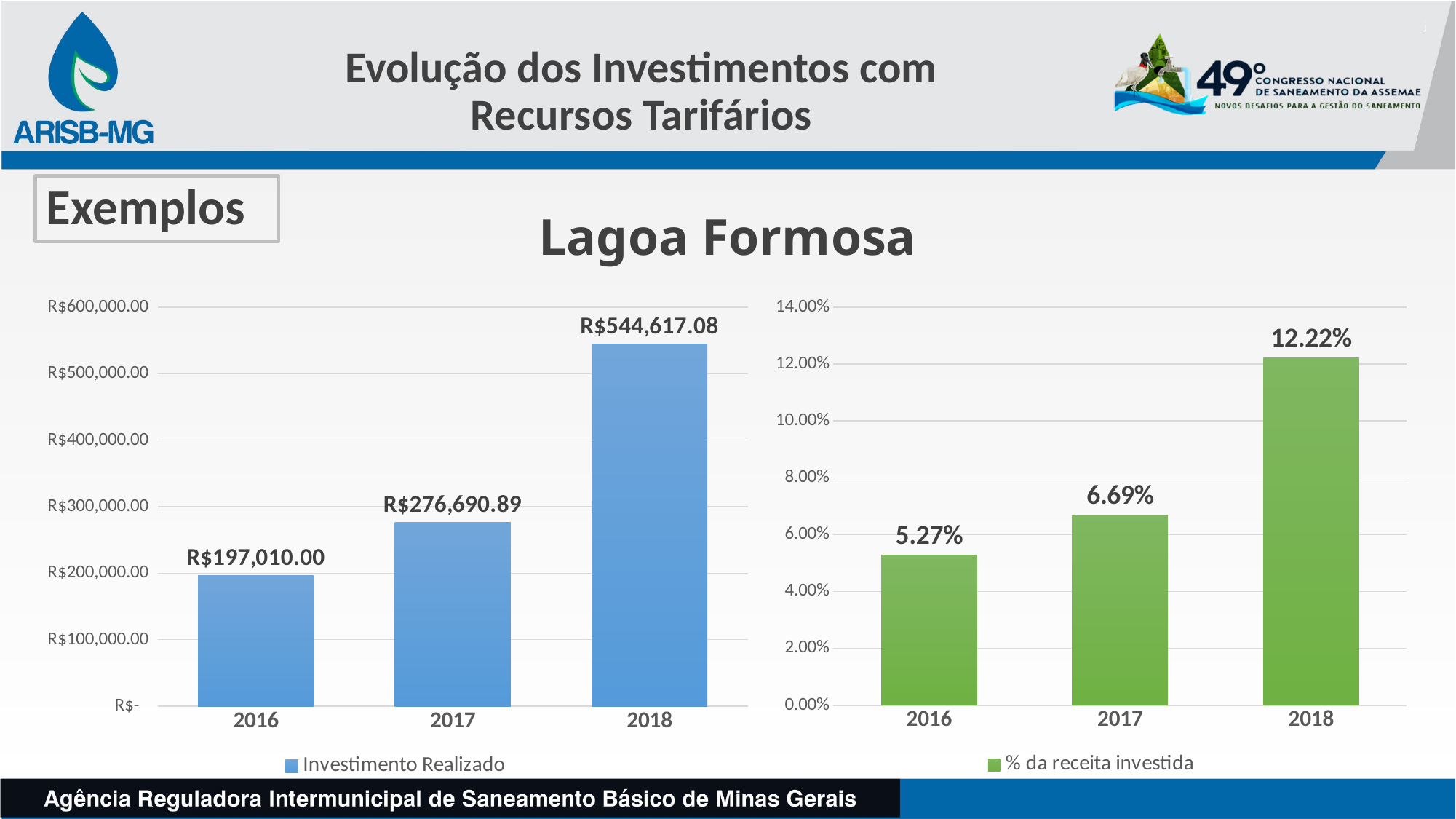
In the left chart (Investimento Realizado), what is the value for 2018? R$544,617.08 In the left chart (Investimento Realizado), what is the value for 2016? R$197,010.00 In the right chart (% da receita investida), which year has the highest value? 2018 In the right chart (% da receita investida), which is larger, the value for 2016 or the value for 2017? 2017 What kind of chart is the right chart (% da receita investida)? bar chart In the left chart (Investimento Realizado), is the value for 2017 greater or less than R$300,000.00? less How many years are shown on the x axis of the left chart (Investimento Realizado)? 3 In the left chart (Investimento Realizado), do the values rise or fall from 2016 to 2018? rise In the right chart (% da receita investida), what is the value for 2017? 6.69% In the right chart (% da receita investida), what is the difference between the 2018 and 2017 values? 5.53% In the left chart (Investimento Realizado), which year has the lowest value? 2016 In the left chart (Investimento Realizado), what is the difference between the 2018 and 2017 values? R$267,926.19